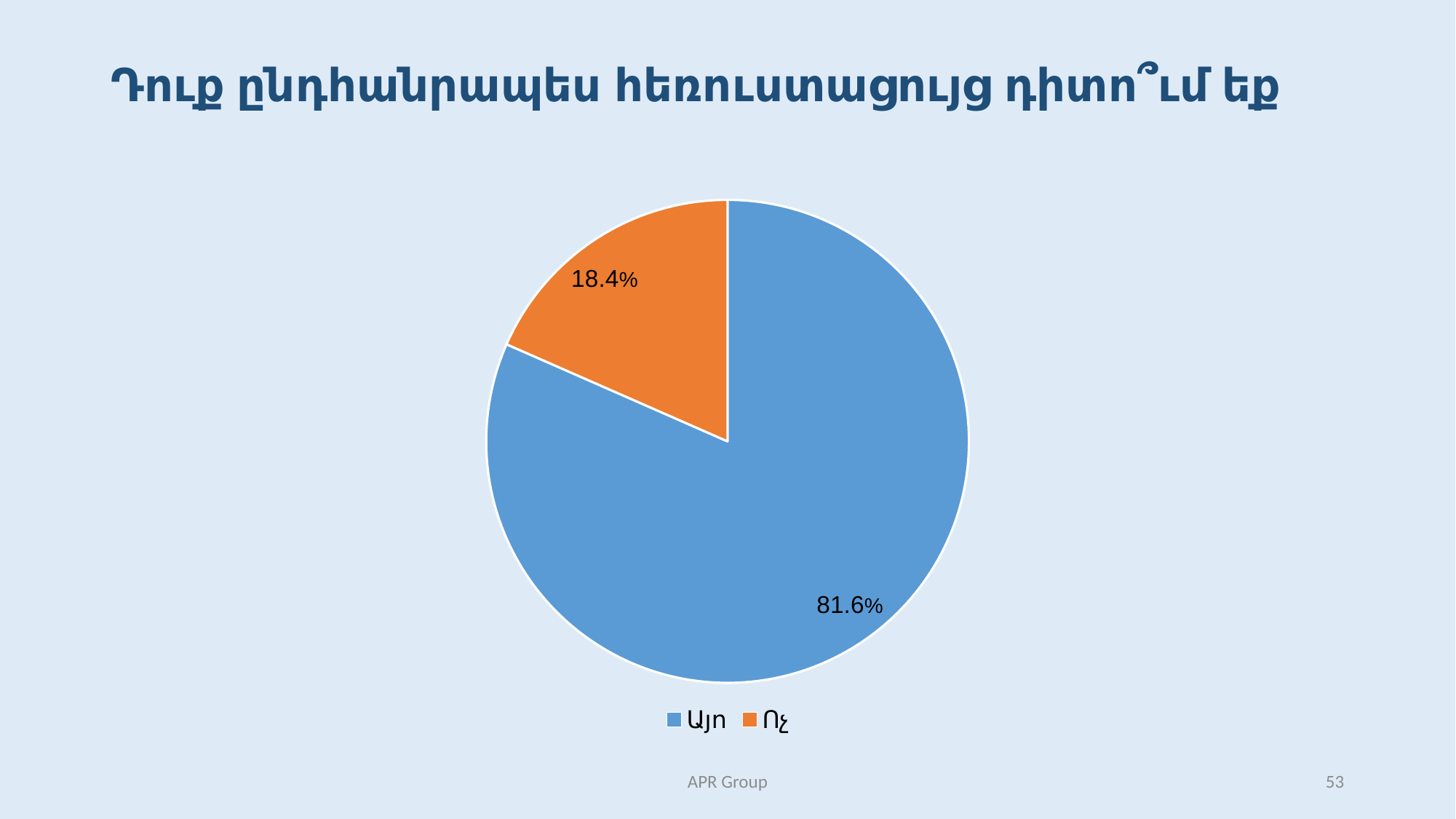
Which category has the smallest slice of the pie? Ոչ What kind of chart is shown on the slide? pie chart What colour is the "Այո" slice? blue What is the difference in percentage points between the "Այո" and "Ոչ" slices? 63.2 What colour is the "Ոչ" slice? orange Which category has the largest slice of the pie? Այո What share of the pie does the "Այո" slice represent? 81.6% How many entries does the legend list? 2 How many slices does the pie chart have? 2 Which is larger, the "Այո" slice or the "Ոչ" slice? Այո What share of the pie does the "Ոչ" slice represent? 18.4%